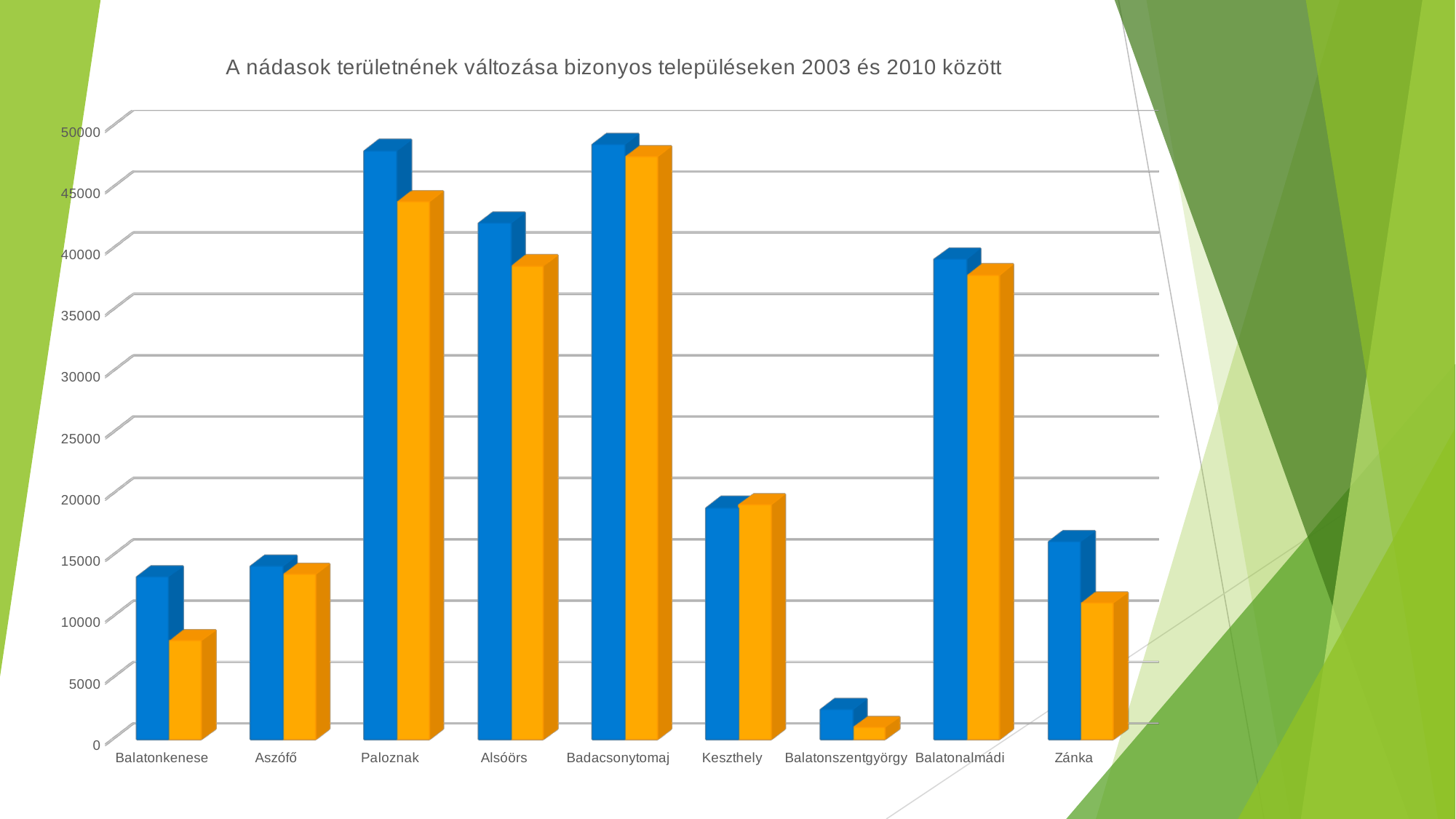
Is the blue bar for Paloznak greater or less than 45000? greater Is the blue bar for Balatonszentgyörgy greater or less than 5000? less For Zánka, which bar is taller, the blue one or the orange one? blue Which settlement has the lowest blue bar? Balatonszentgyörgy What kind of chart is shown on the slide? bar chart Is the orange bar for Balatonkenese greater or less than 10000? less Which settlement has the highest orange bar? Badacsonytomaj For Balatonkenese, which bar is taller, the blue one or the orange one? blue What is the title of the chart? A nádasok területnének változása bizonyos településeken 2003 és 2010 között How many settlements (categories) are shown on the x axis? 9